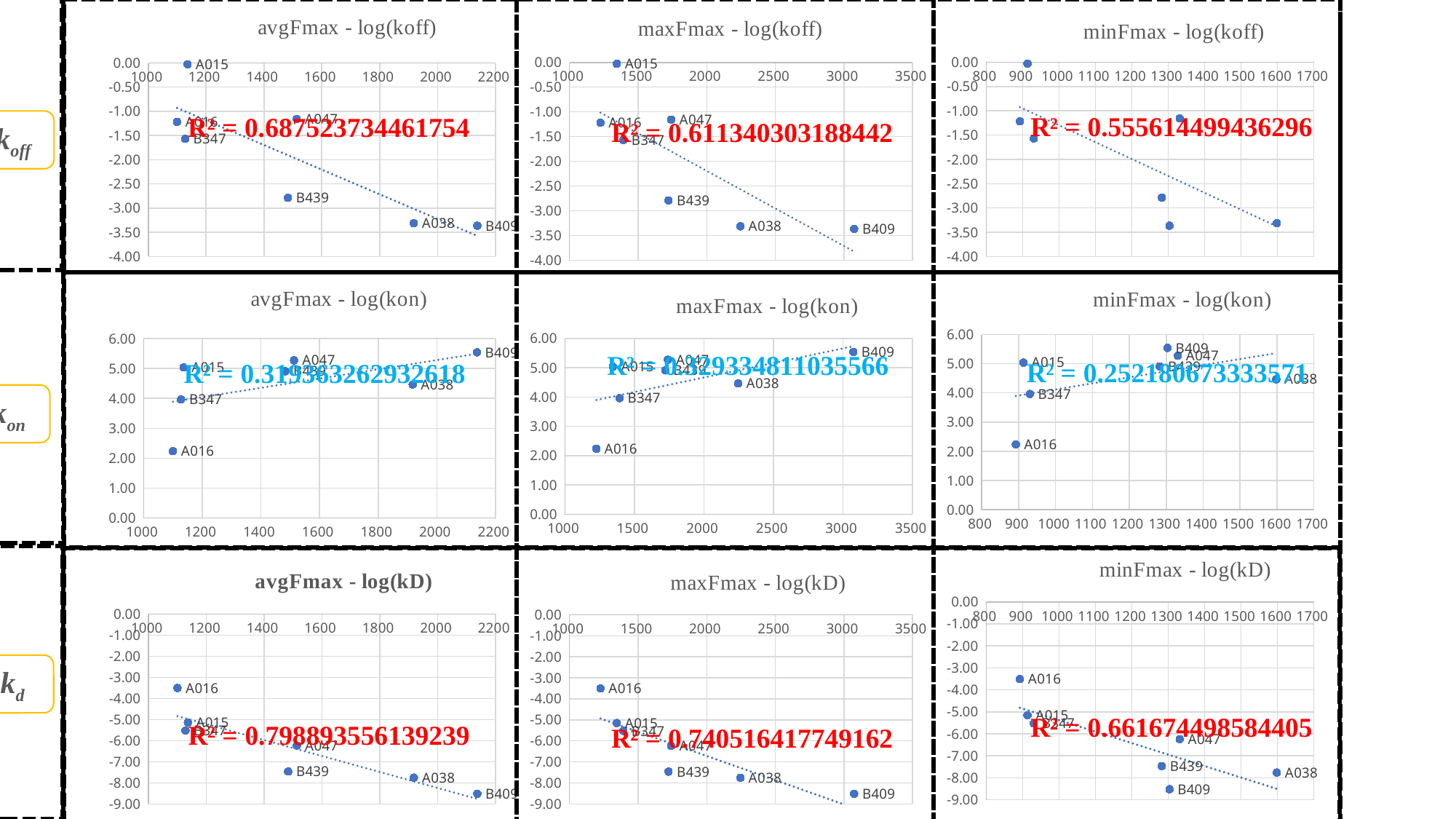
What R² value is printed on the avgFmax - log(kD) chart? R² = 0.798893556139239 What R² value is printed on the minFmax - log(kon) chart? R² = 0.252180673333571 In the maxFmax - log(kon) chart, is the value for A016 greater or less than 3.00? less In the avgFmax - log(kD) chart, which has the larger value, A016 or B439? A016 In the avgFmax - log(kon) chart, is the value for A016 greater or less than 3.00? less In the avgFmax - log(kon) chart, does the dotted trend line rise or fall from left to right? rise How many charts are shown on the slide? 9 In the avgFmax - log(kon) chart, which labelled point has the lowest value? A016 In the avgFmax - log(koff) chart, is the value for B409 greater or less than -3.00? less What kind of chart is the avgFmax - log(koff) chart at the top left? scatter chart In the avgFmax - log(kD) chart, which labelled point has the highest value? A016 In the avgFmax - log(koff) chart, does the dotted trend line rise or fall from left to right? fall